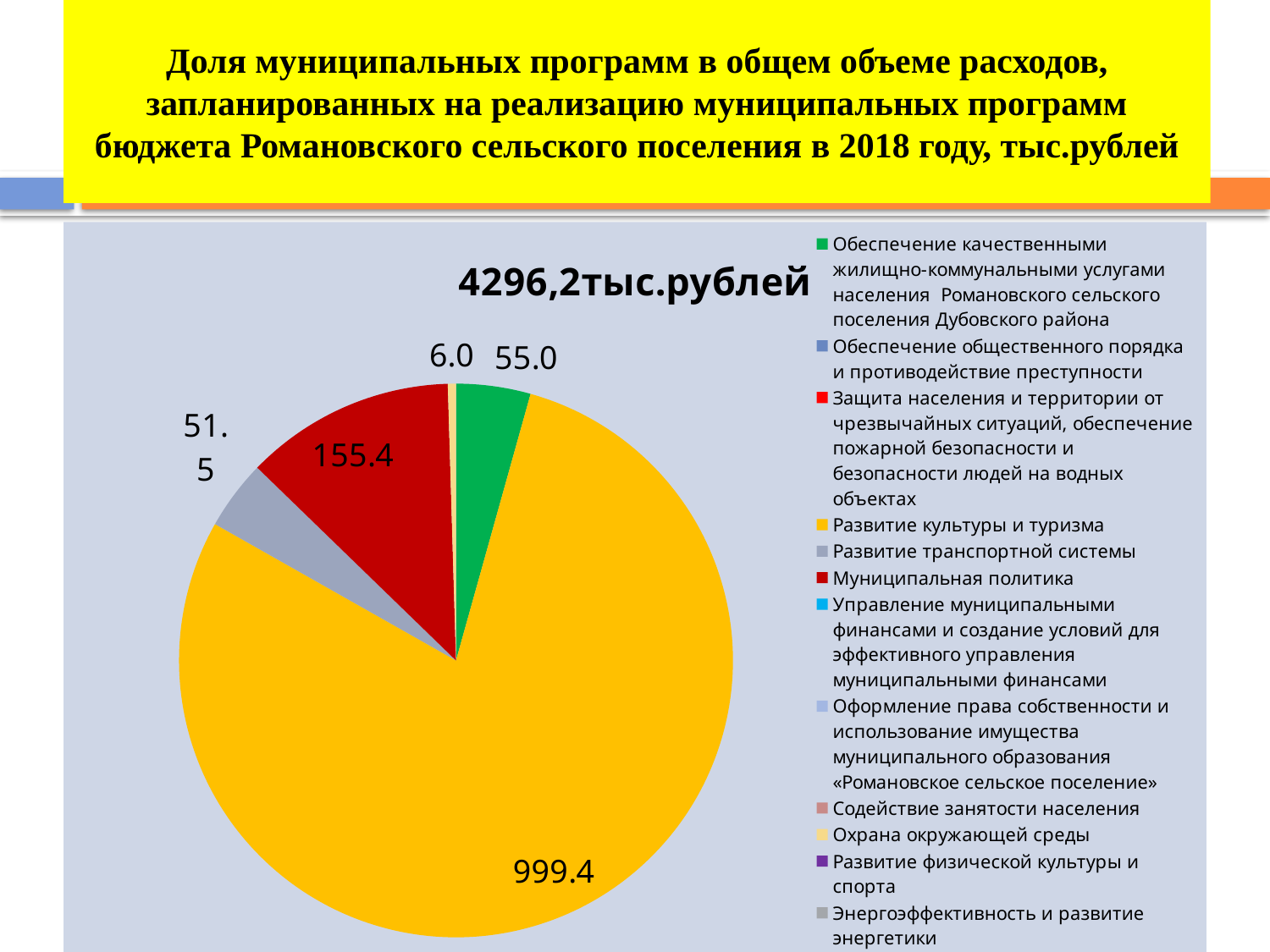
What value is labelled on the dark red slice of the pie chart? 155.4 Which slice has the largest value in the pie chart? 999.4 (Развитие культуры и туризма) Which is larger: the dark red slice or the green slice? the dark red slice (155.4) How many slices with data labels does the pie chart have? 5 What is the difference between the largest slice (999.4) and the dark red slice (155.4)? 844.0 What is the difference between the green slice (55.0) and the grey slice (51.5)? 3.5 What value is labelled on the green slice of the pie chart? 55.0 What is the smallest value labelled on the pie chart? 6.0 What type of chart is shown on the slide? pie chart What total amount is shown in the chart title above the pie? 4296,2тыс.рублей What value is labelled on the largest (yellow) slice of the pie chart? 999.4 What value is labelled on the grey slice of the pie chart? 51.5